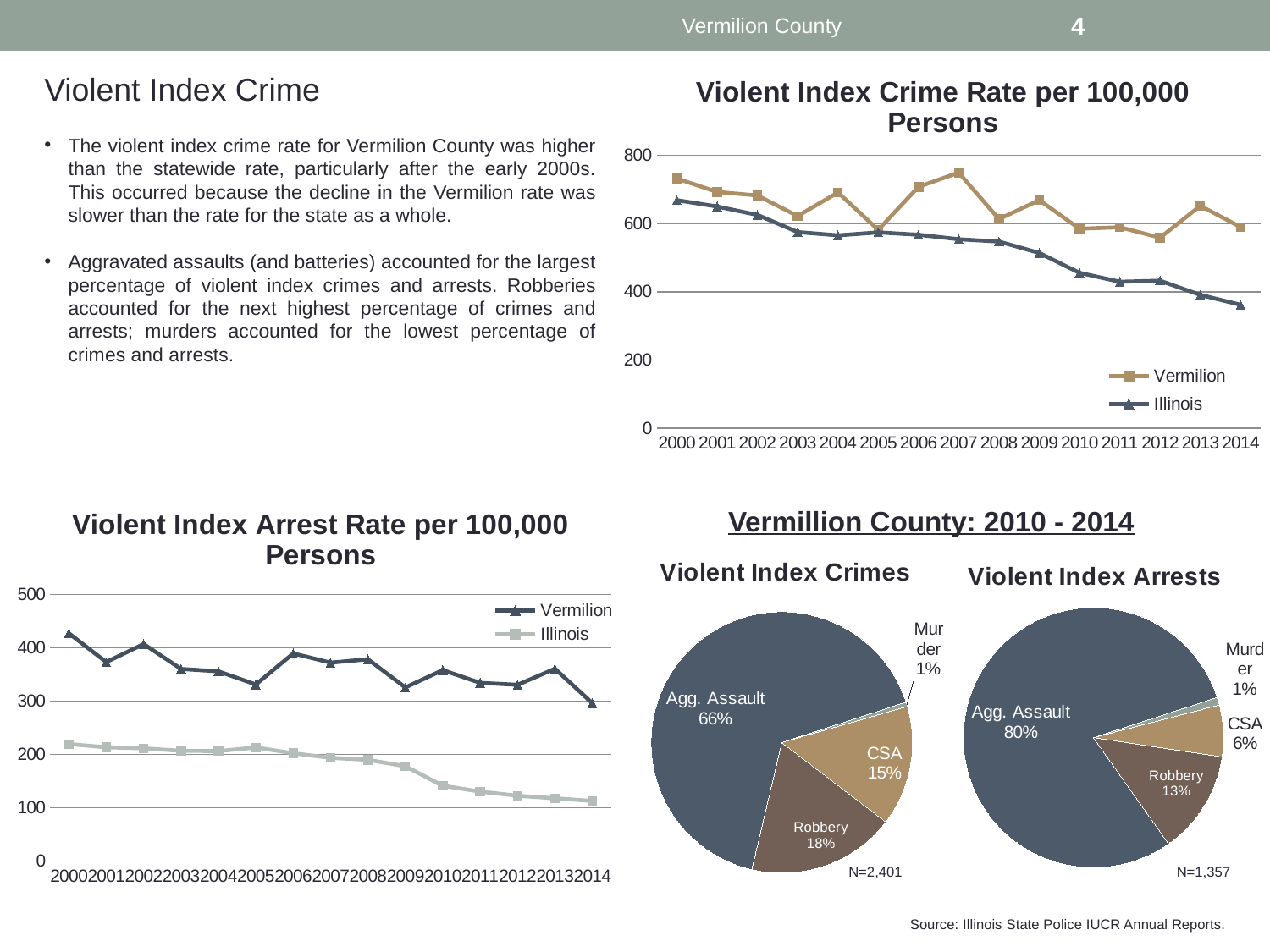
In the Violent Index Crime Rate per 100,000 Persons chart, is the Illinois value for 2014 greater or less than 400? less How many slices does the Violent Index Crimes pie chart have? 4 In the Violent Index Crimes pie chart, what percentage of crimes were Agg. Assault? 66% How many percentage points higher is the Agg. Assault share in the Violent Index Arrests pie than in the Violent Index Crimes pie? 14 percentage points In the Violent Index Crime Rate per 100,000 Persons chart, is the Vermilion value for 2007 greater or less than 600? greater In the Violent Index Arrests pie chart, what share of arrests were for Robbery? 13% In the Violent Index Crimes pie chart, which category has the largest slice? Agg. Assault What type of chart is the Violent Index Crime Rate per 100,000 Persons chart? Line chart How many series does the legend of the Violent Index Crime Rate per 100,000 Persons chart list? 2 In the Violent Index Arrests pie chart, which category has the smallest slice? Murder In the Violent Index Arrest Rate per 100,000 Persons chart, which series has the higher value in 2014, Vermilion or Illinois? Vermilion In the Violent Index Arrest Rate per 100,000 Persons chart, does the Illinois series rise or fall from 2000 to 2014? Fall